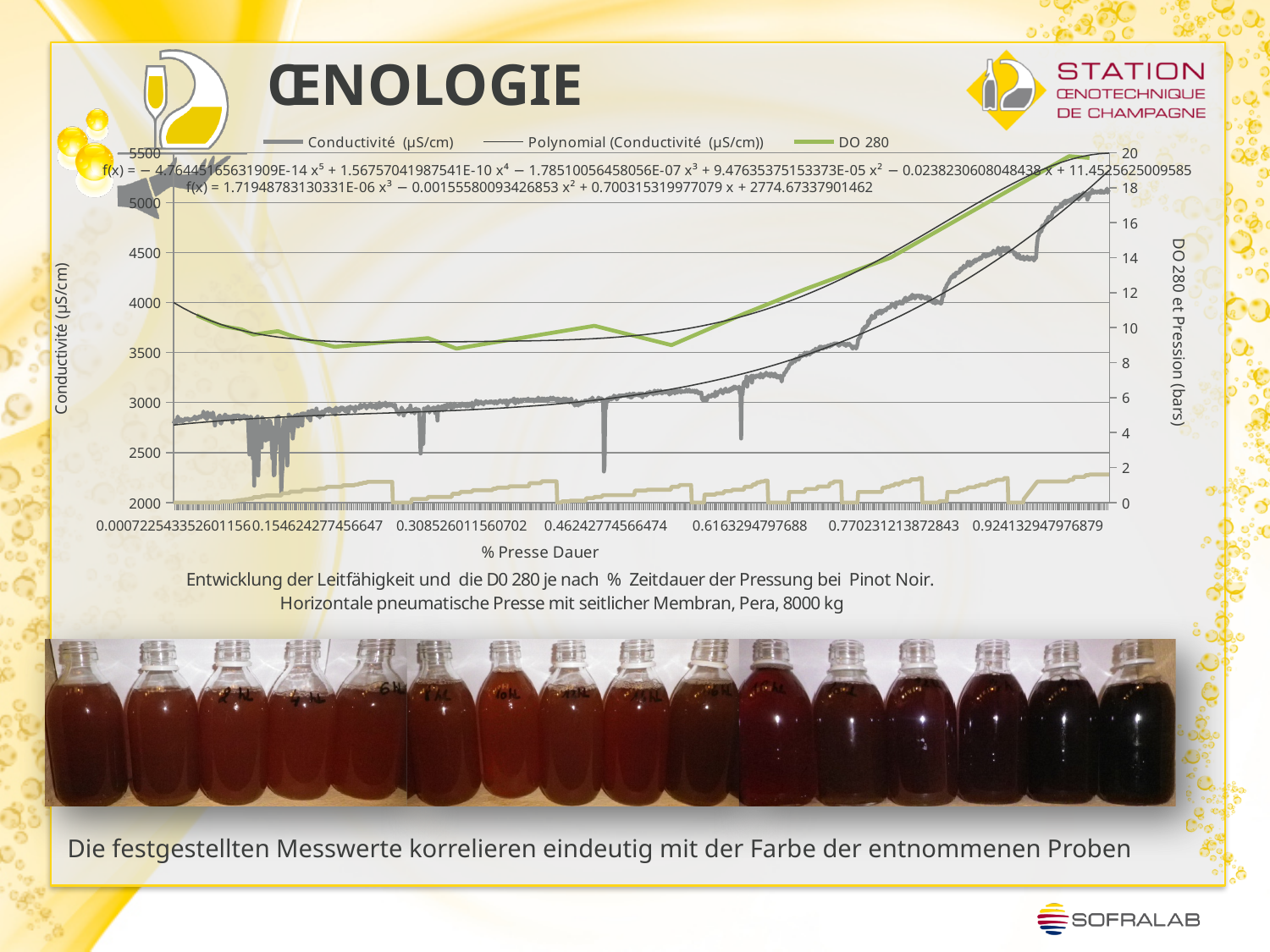
Does the DO 280 series overall rise or fall across the right half of the chart? rise How many series does the chart legend list? 3 At the right end of the chart, is the Conductivité (µS/cm) value greater or less than 5000? greater Which series is drawn in green in the chart? DO 280 At the left end of the chart, is the Conductivité (µS/cm) value greater or less than 3000? less What kind of chart is shown on the slide? line chart What is the title of the left vertical axis of the chart? Conductivité (µS/cm) What is the title of the horizontal axis of the chart? % Presse Dauer What is the highest tick value shown on the right vertical axis? 20 What is the highest tick value shown on the left vertical axis? 5500 At the right end of the chart, is the DO 280 value greater or less than 16? greater Does the Conductivité (µS/cm) series overall rise or fall from left to right along the x axis? rise